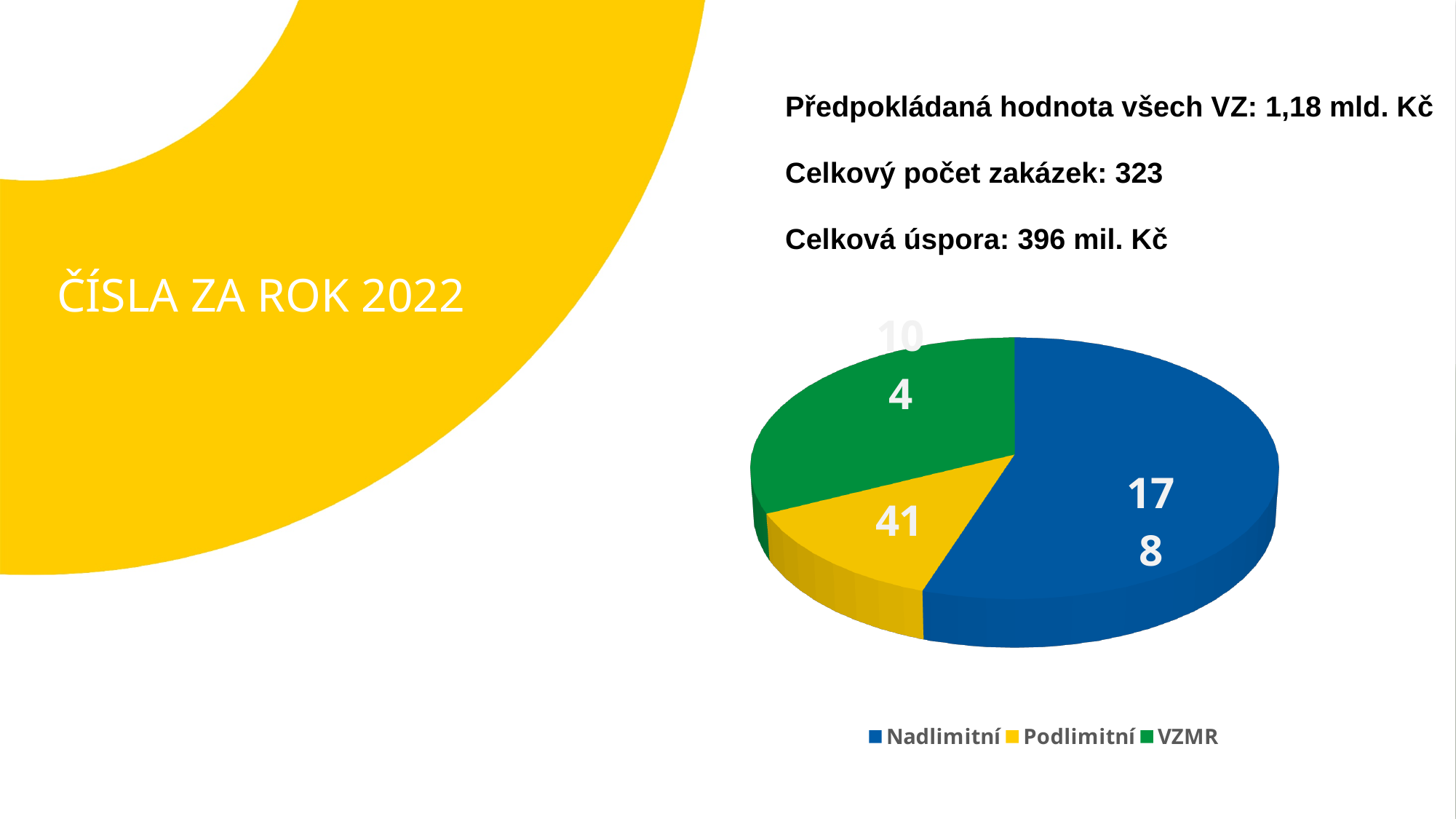
What is the value for Nadlimitní in the pie chart? 178 What is the value for VZMR in the pie chart? 104 What is the value for Podlimitní in the pie chart? 41 Which category has the largest slice in the pie chart? Nadlimitní Which category has the smallest slice in the pie chart? Podlimitní Which is larger, the value for VZMR or the value for Podlimitní? VZMR What colour is the Podlimitní slice in the pie chart? Yellow What is the total of all slices in the pie chart? 323 What is the difference between the values for Nadlimitní and Podlimitní? 137 How many series does the legend of the pie chart list? 3 What is the difference between the values for VZMR and Podlimitní? 63 What type of chart is shown on the slide? Pie chart